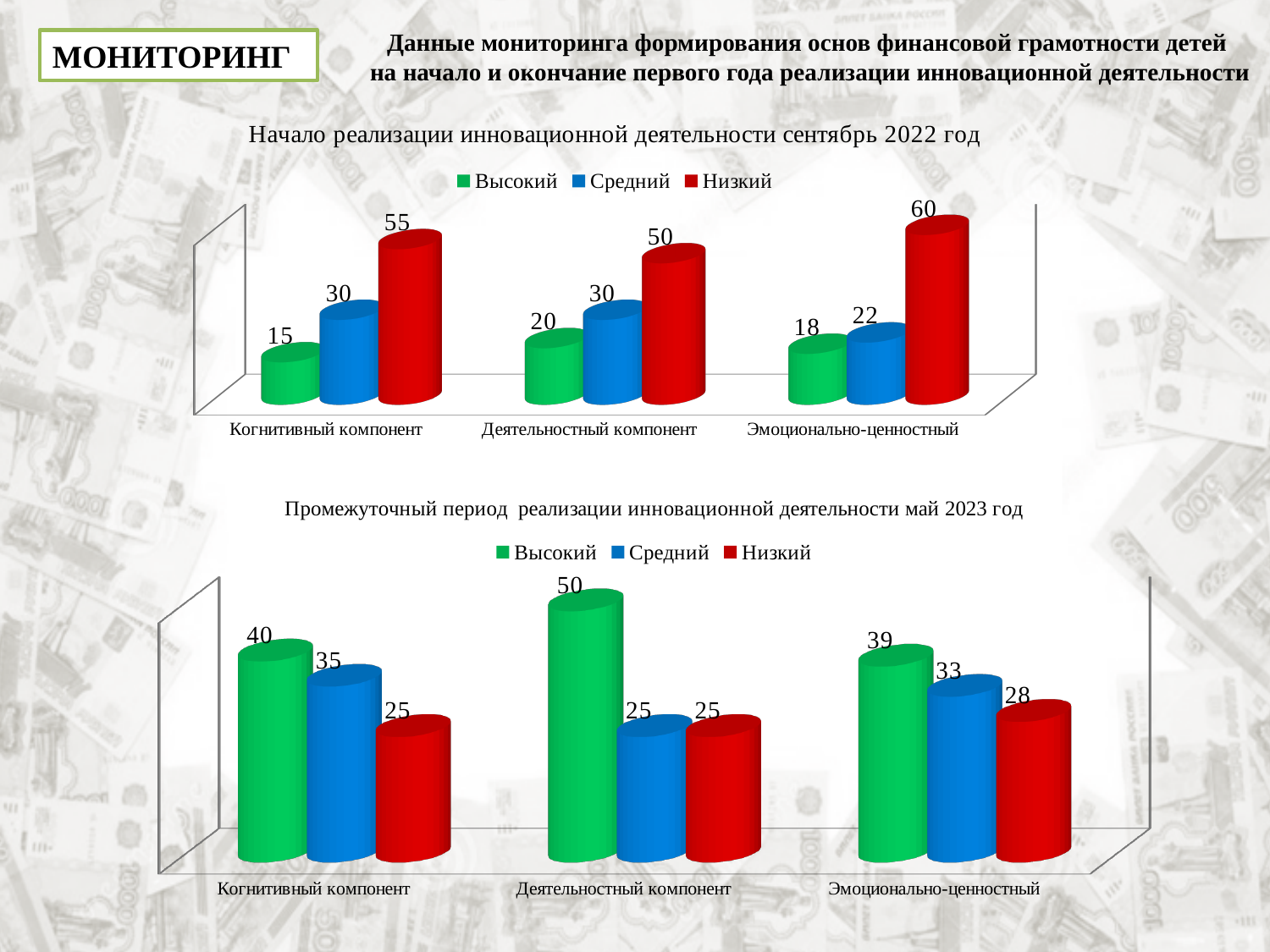
In the top chart (September 2022), what is the difference between the Низкий and Высокий values for Деятельностный компонент? 30 In the bottom chart (May 2023), what is the difference between the Высокий and Средний values for Когнитивный компонент? 5 In the top chart (September 2022), what is the value of Высокий for Эмоционально-ценностный? 18 In the bottom chart (May 2023), which category has the highest Высокий value? Деятельностный компонент What type of chart is the bottom chart (May 2023)? Bar chart In the bottom chart (May 2023), which is larger for Когнитивный компонент: Высокий or Низкий? Высокий In the bottom chart (May 2023), what is the value of Высокий for Деятельностный компонент? 50 How many series does the legend of the top chart list? 3 In the top chart (September 2022), what is the value of Низкий for Когнитивный компонент? 55 In the top chart (September 2022), which category has the highest Низкий value? Эмоционально-ценностный In the top chart (September 2022), which category has the lowest Высокий value? Когнитивный компонент In the bottom chart (May 2023), what is the value of Средний for Эмоционально-ценностный? 33